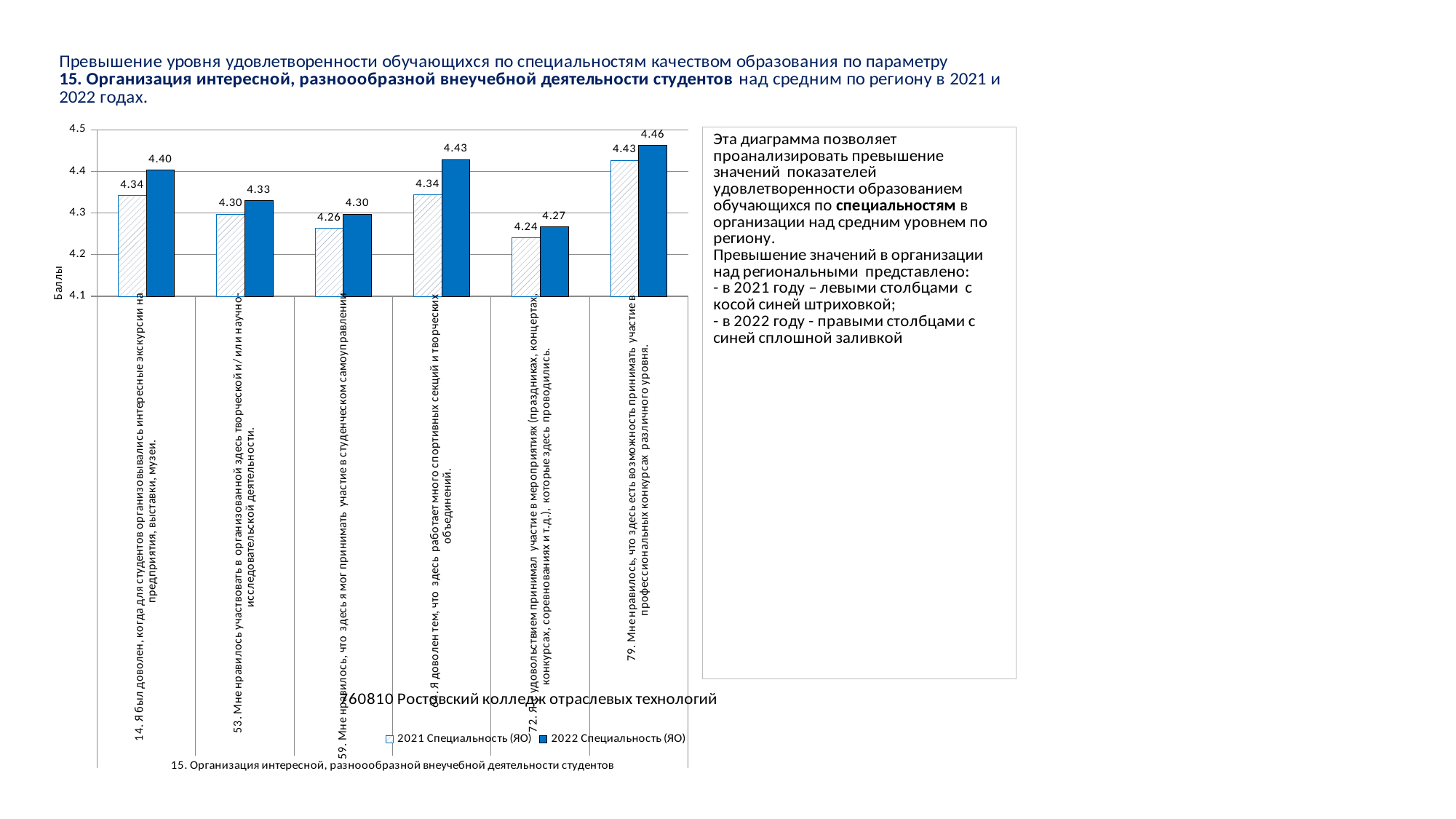
Which category has the lowest 2021 Специальность (ЯО) value? 72. Я с удовольствием принимал участие в мероприятиях (праздниках, концертах, конкурсах, соревнованиях и т.д.), которые здесь проводились How many categories are shown on the x axis of the chart? 6 Which category has the highest 2022 Специальность (ЯО) value? 79. Мне нравилось, что здесь есть возможность принимать участие в профессиональных конкурсах различного уровня How many series does the chart legend list? 2 What is the 2021 Специальность (ЯО) value for category 72 (участие в мероприятиях: праздниках, концертах, конкурсах)? 4.24 Which is larger for category 53 (творческая и/или научно-исследовательская деятельность): the 2021 value or the 2022 value? 2022 value (4.33) What is the 2022 Специальность (ЯО) value for category 14 (интересные экскурсии на предприятия, выставки, музеи)? 4.40 What type of chart is shown on the slide? Bar chart Is the 2021 Специальность (ЯО) value for category 79 greater or less than 4.4? greater What is the 2021 Специальность (ЯО) value for category 59 (участие в студенческом самоуправлении)? 4.26 What is the difference between the 2022 and 2021 values for the category about спортивных секций и творческих объединений? 0.09 What is the label of the vertical axis of the chart? Баллы